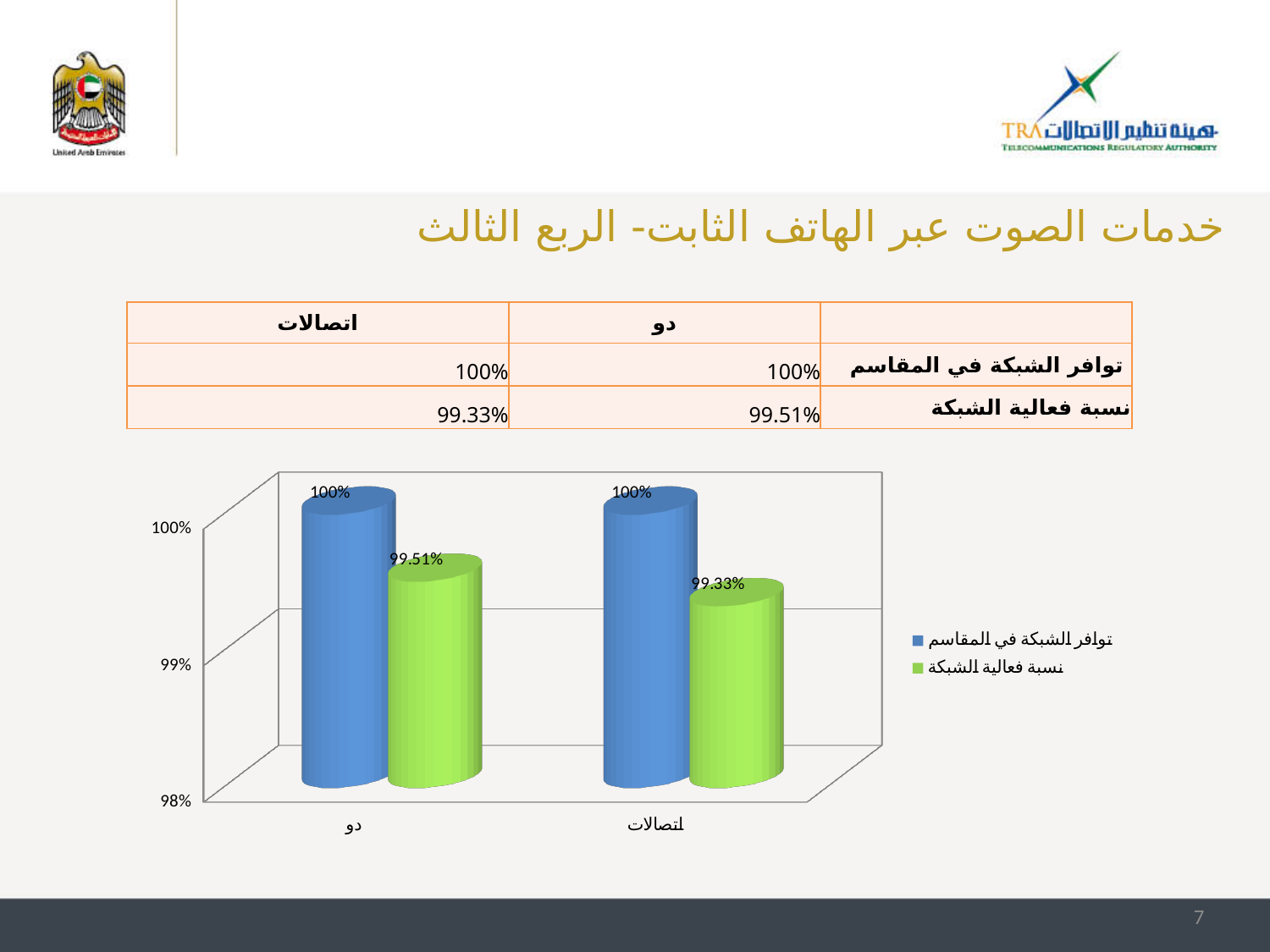
How many categories are shown on the x axis of the chart? 2 How many series does the chart legend list? 2 What is the value of نسبة فعالية الشبكة for اتصالات in the chart? 99.33% Which category has the lower value for نسبة فعالية الشبكة? اتصالات Which series is shown in green in the chart? نسبة فعالية الشبكة Which category has the higher value for نسبة فعالية الشبكة? دو Is the value of نسبة فعالية الشبكة for اتصالات greater or less than 99%? greater What is the value of توافر الشبكة في المقاسم for دو in the chart? 100% What is the value of نسبة فعالية الشبكة for دو in the chart? 99.51% What is the value of توافر الشبكة في المقاسم for اتصالات in the chart? 100% What type of chart is shown on the slide? bar chart What is the difference between the نسبة فعالية الشبكة values for دو and اتصالات? 0.18%